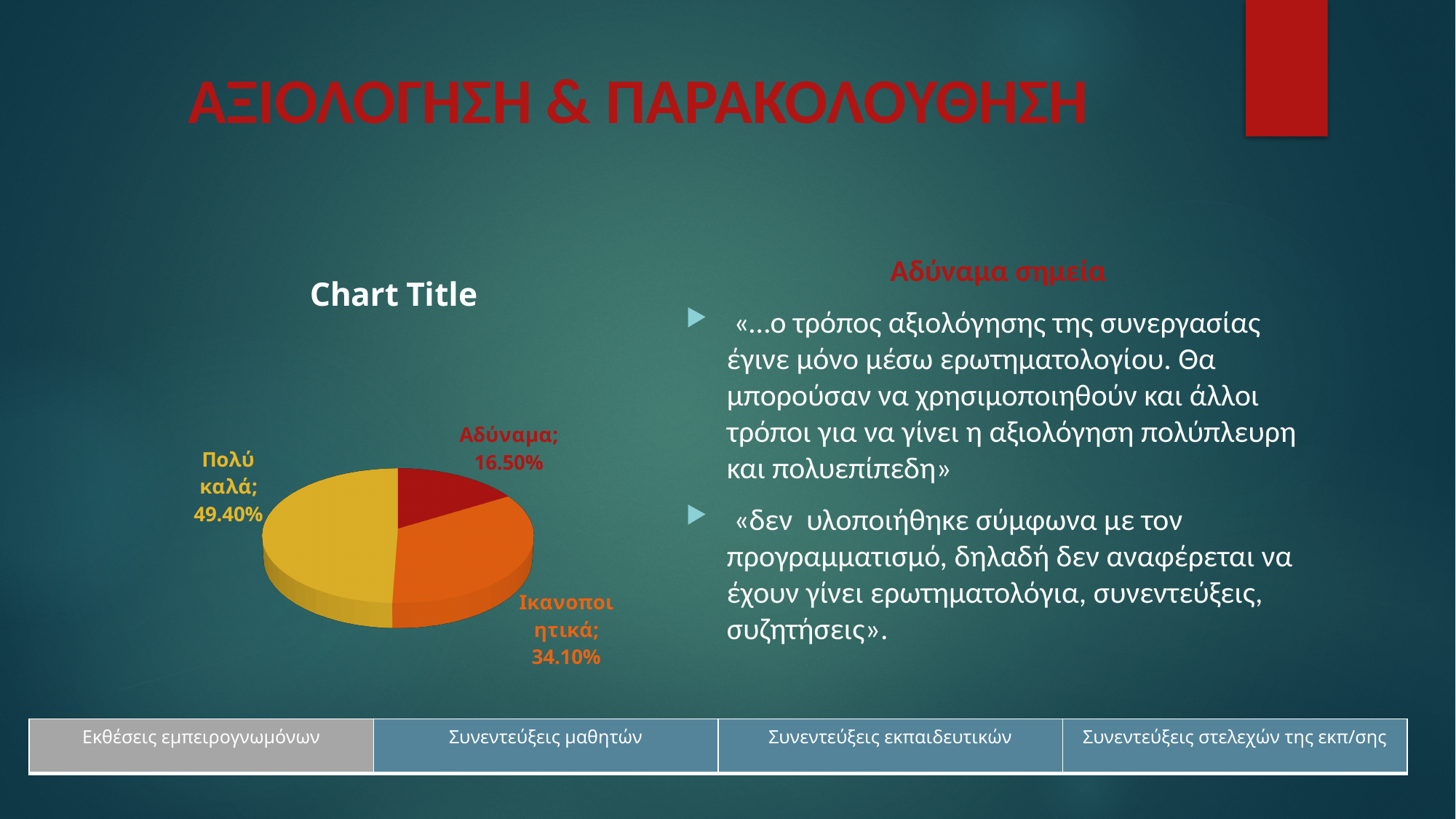
What is the value for Πολύ καλά in the pie chart? 49.40% What is the title of the chart? Chart Title What is the value for Αδύναμα in the pie chart? 16.50% What is the value for Ικανοποιητικά in the pie chart? 34.10% What is the difference between the values for Ικανοποιητικά and Αδύναμα? 17.60% Which is larger, the slice for Ικανοποιητικά or the slice for Αδύναμα? Ικανοποιητικά What is the difference between the values for Πολύ καλά and Ικανοποιητικά? 15.30% Which category has the largest slice in the pie chart? Πολύ καλά What colour is the slice for Αδύναμα? Red What kind of chart is shown on the slide? Pie chart How many slices does the pie chart have? 3 Which category has the smallest slice in the pie chart? Αδύναμα